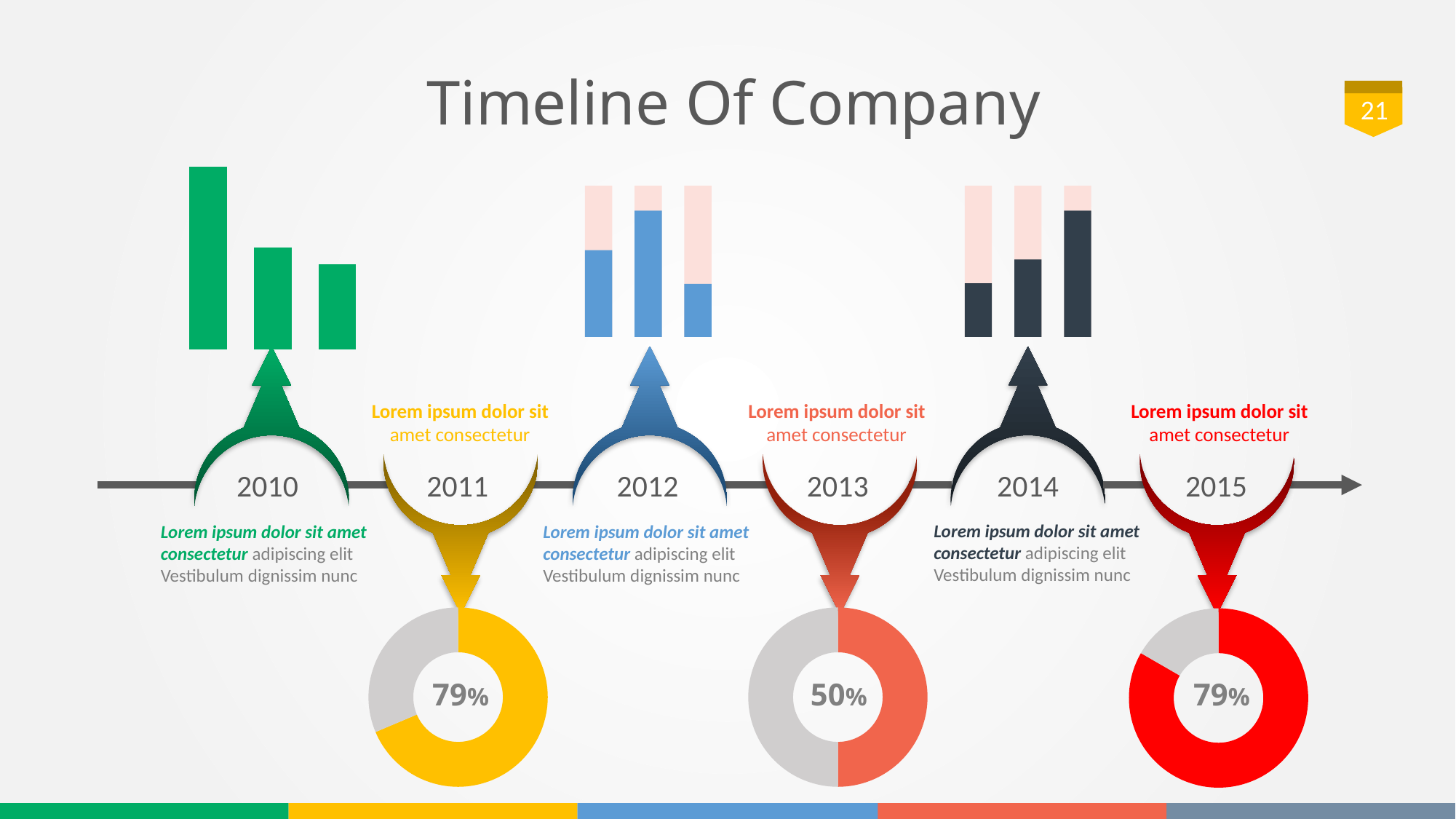
What percentage is shown in the donut chart below 2013? 50% In the blue bar chart above 2012, which bar is the tallest: left, middle or right? Middle What percentage is shown in the donut chart below 2011? 79% Which is larger, the percentage in the 2011 donut chart or the 2013 donut chart? 2011 How many bars are in the green chart above 2010? 3 What kind of chart is shown below 2013? Donut chart What percentage is shown in the donut chart below 2015? 79% In the green bar chart above 2010, do the bars rise or fall from left to right? Fall Which year's donut chart shows the lowest percentage? 2013 In the dark bar chart above 2014, which bar is the shortest: left, middle or right? Left What kind of chart is shown above 2010? Bar chart What is the difference between the percentage in the 2011 donut chart and the 2013 donut chart? 29%